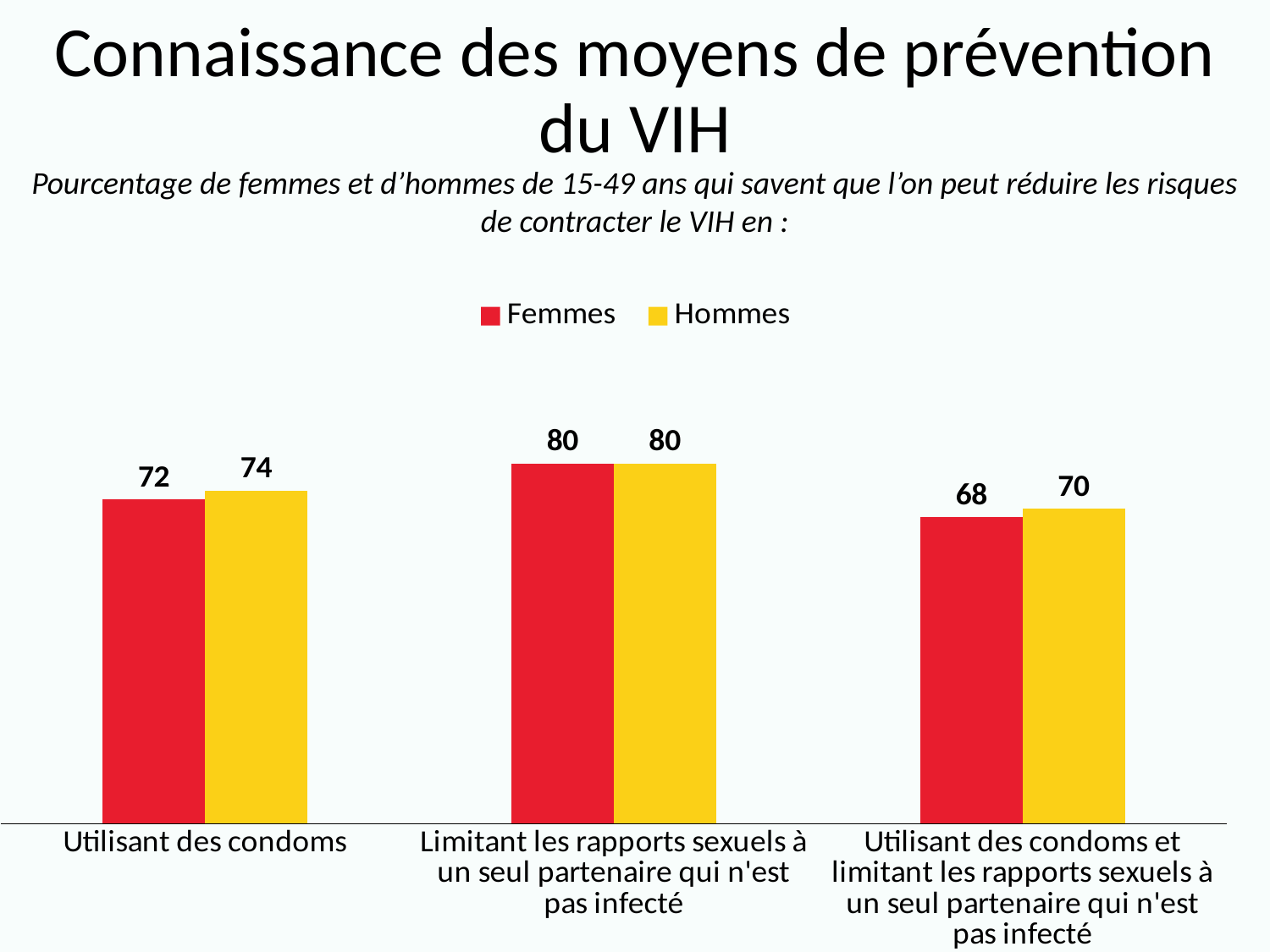
Which category has the highest value for Hommes? Limitant les rapports sexuels à un seul partenaire qui n'est pas infecté What is the value for Hommes in the 'Utilisant des condoms et limitant les rapports sexuels à un seul partenaire qui n'est pas infecté' category? 70 How many categories are shown on the x axis? 3 Which colour represents the Femmes series? Red Which category has the lowest value for Femmes? Utilisant des condoms et limitant les rapports sexuels à un seul partenaire qui n'est pas infecté Which is larger in the 'Utilisant des condoms et limitant les rapports sexuels à un seul partenaire qui n'est pas infecté' category: Femmes or Hommes? Hommes What is the value for Femmes in the 'Utilisant des condoms' category? 72 What is the difference between the Hommes and Femmes values in the 'Utilisant des condoms' category? 2 What is the value for Femmes in the 'Limitant les rapports sexuels à un seul partenaire qui n'est pas infecté' category? 80 What is the value for Hommes in the 'Utilisant des condoms' category? 74 What kind of chart is shown on the slide? Bar chart How many series does the legend list? 2